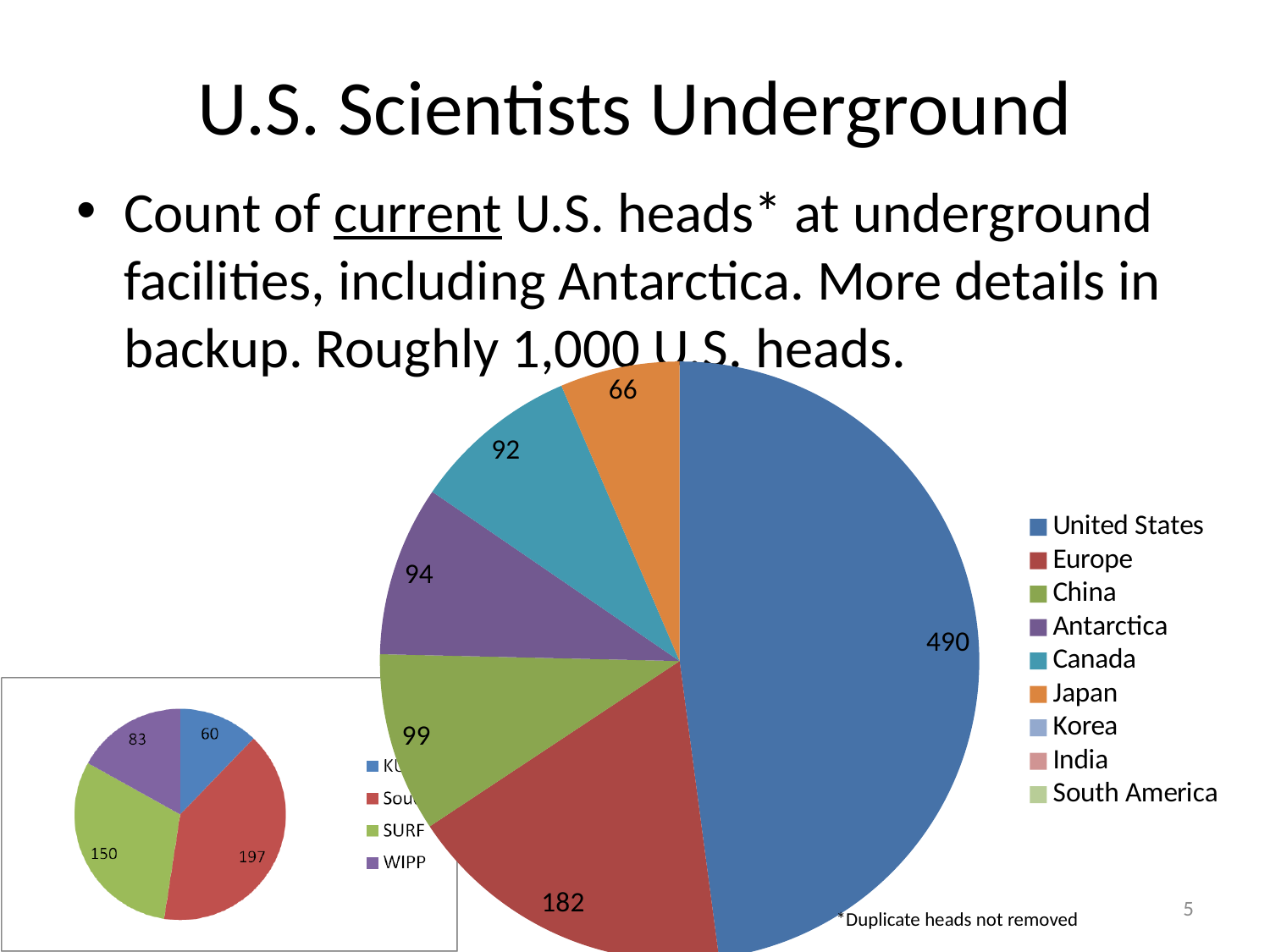
What kind of chart is the large chart on the slide? Pie chart In the small inset pie chart at the bottom left, what is the value for WIPP? 83 In the large pie chart, what is the difference between the United States value and the Europe value? 308 In the small inset pie chart at the bottom left, what is the difference between the SURF value and the WIPP value? 67 How many slices does the small inset pie chart at the bottom left have? 4 In the large pie chart, which category has the largest slice? United States In the large pie chart, what is the value for United States? 490 In the large pie chart, which is larger, the value for China or the value for Canada? China In the large pie chart, what is the value for Japan? 66 In the small inset pie chart at the bottom left, what is the value for SURF? 150 In the large pie chart, what is the value for Europe? 182 How many entries does the legend of the large pie chart list? 9